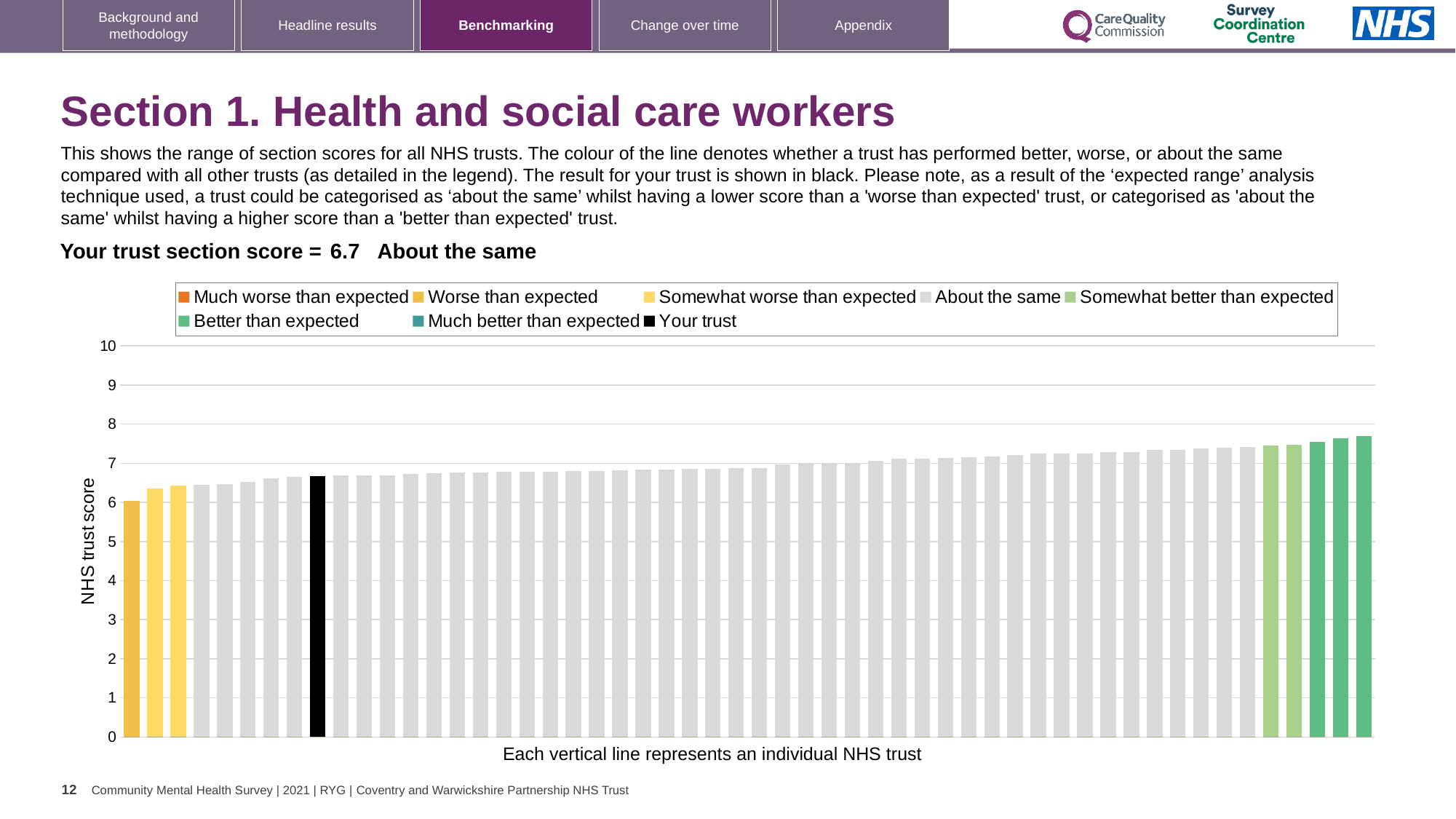
What is the section score for your trust shown on the slide? 6.7 How many entries does the chart legend list? 8 What is the label on the vertical axis of the chart? NHS trust score How many bars are coloured as 'Somewhat worse than expected'? 2 Is the value of the black 'Your trust' bar greater or less than 7? less Which performance category is your trust placed in for this section? About the same What kind of chart is shown on the slide? bar chart Is the value of the tallest bar in the chart greater or less than 8? less Do the bar values rise or fall moving from left to right along the x axis? rise How many bars are coloured as 'Better than expected'? 3 Is the 'Your trust' bar higher or lower than the rightmost bar in the chart? lower Is the value of the shortest bar in the chart greater or less than 5? greater